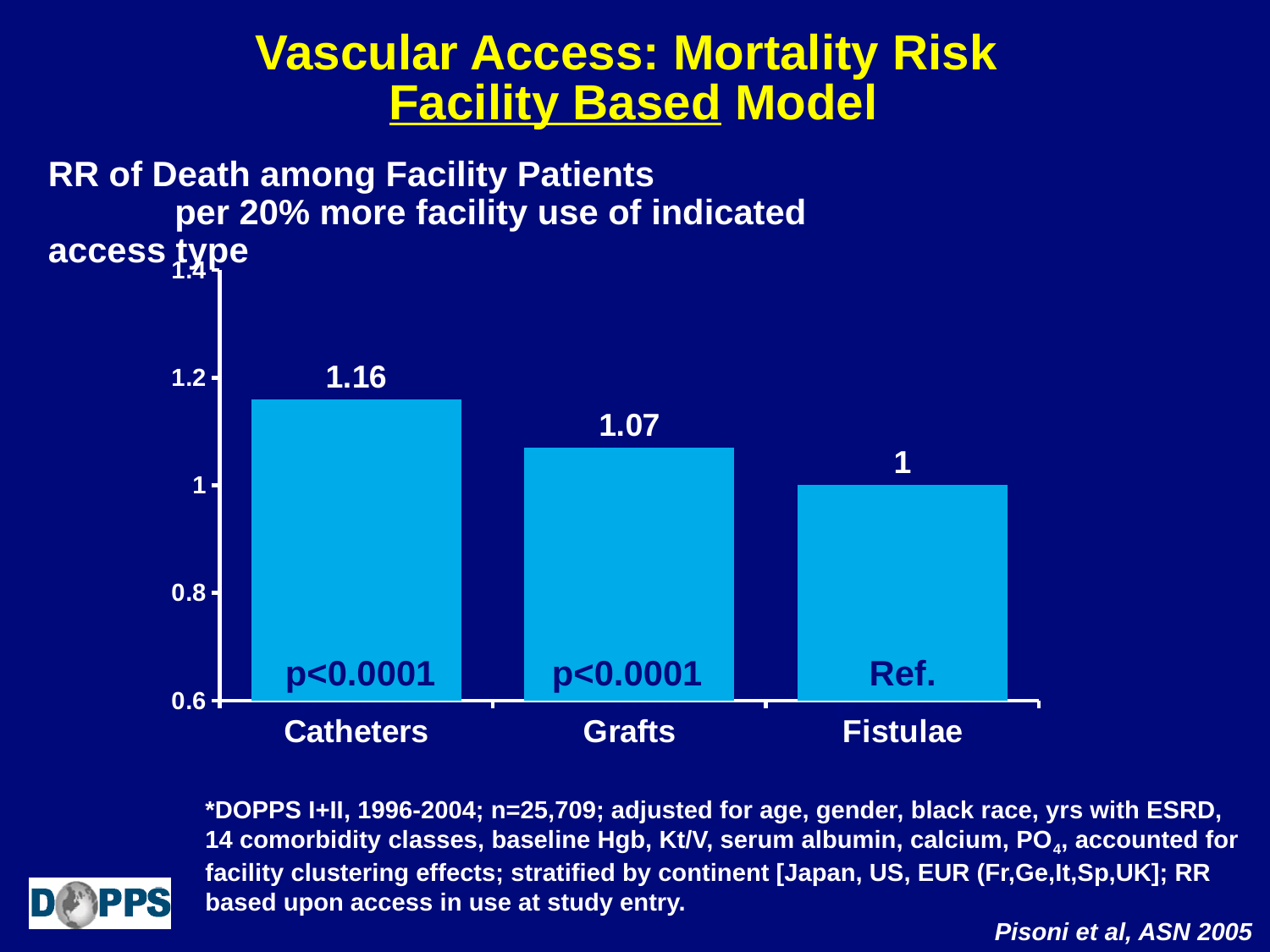
What is the RR of death value for Fistulae? 1 Which has a larger RR of death, Grafts or Fistulae? Grafts Is the value for Grafts greater or less than 1.2? less What is the RR of death value for Grafts? 1.07 What is the difference between the RR values for Catheters and Grafts? 0.09 Which access type has the highest RR of death? Catheters What is the RR of death value for Catheters? 1.16 What kind of chart is shown on the slide? Bar chart What is the difference between the RR values for Catheters and Fistulae? 0.16 How many access types are shown on the chart? 3 What p-value label is printed on the Catheters bar? p<0.0001 Which access type has the lowest RR of death? Fistulae